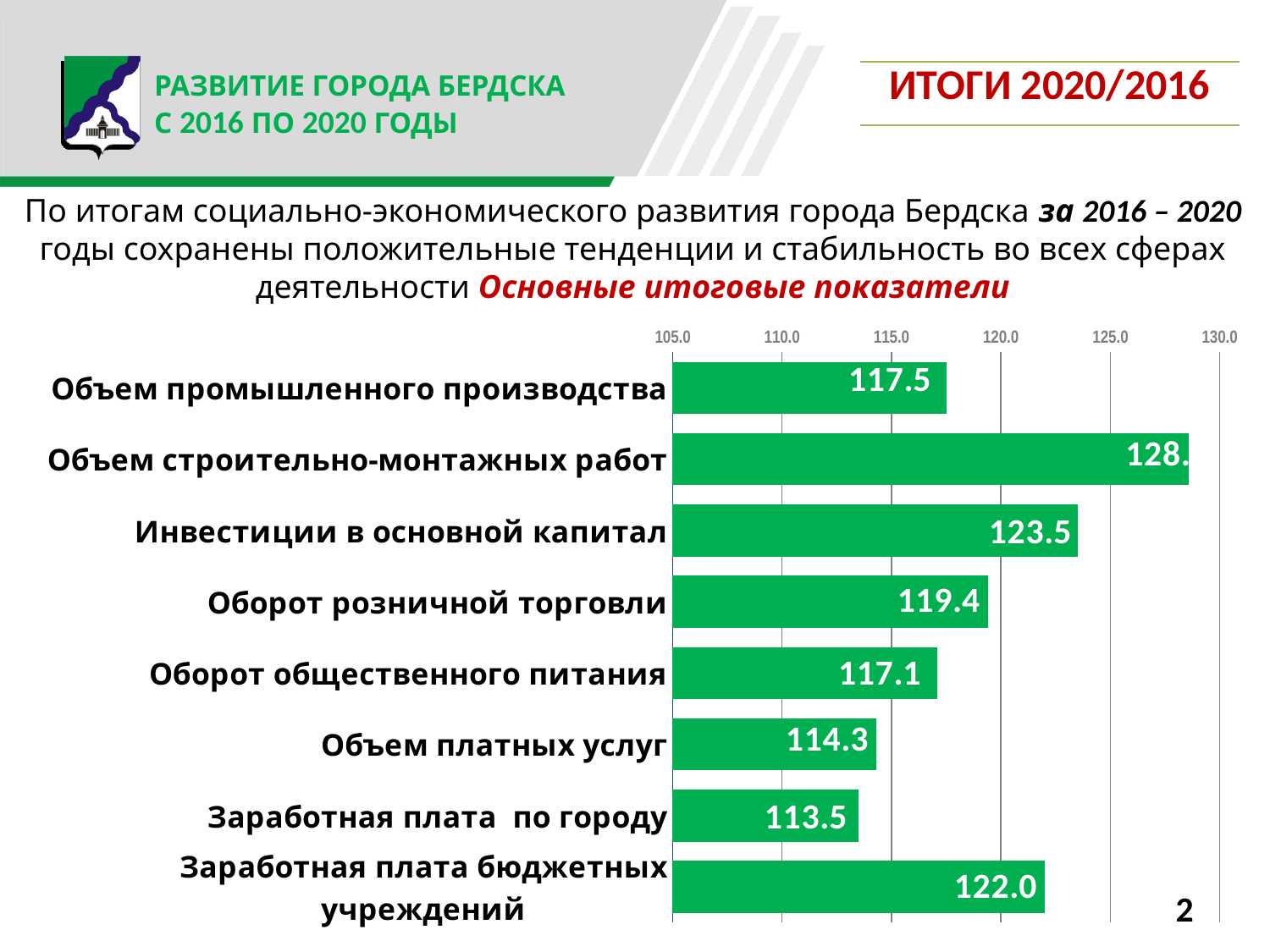
What colour are the bars in the chart? green What is the difference between the values for Инвестиции в основной капитал and Объем платных услуг? 9.2 Which is larger: the value for Оборот общественного питания or the value for Объем платных услуг? Оборот общественного питания Which category has the lowest value? Заработная плата по городу What is the value for Оборот розничной торговли? 119.4 Which category has the highest value? Объем строительно-монтажных работ What is the value for Заработная плата бюджетных учреждений? 122.0 What is the value for Инвестиции в основной капитал? 123.5 What kind of chart is shown on the slide? bar chart What is the value for Объем промышленного производства? 117.5 How many categories are shown in the chart? 8 Is the value for Объем строительно-монтажных работ greater or less than 125.0? greater